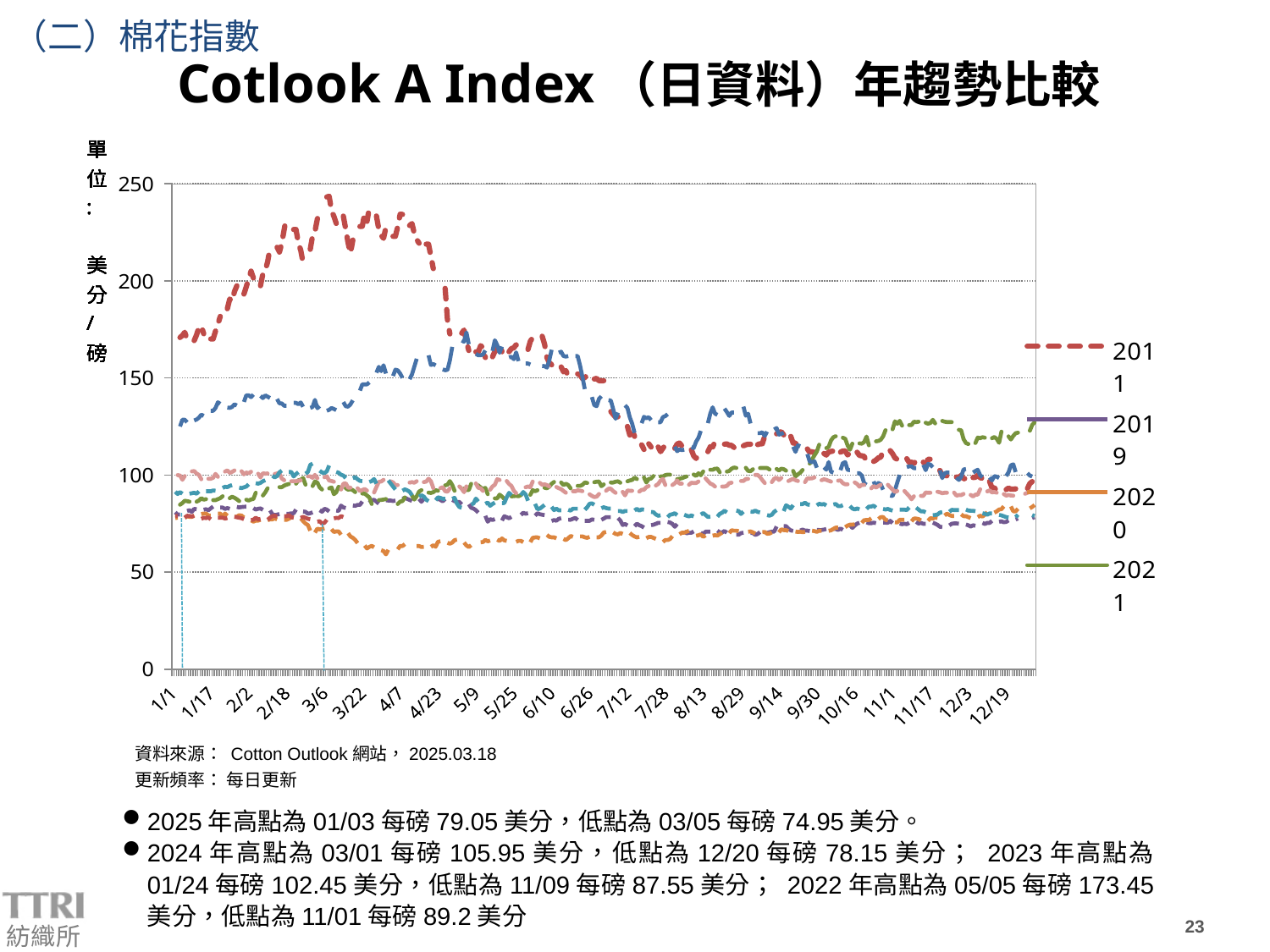
Is the value for the 2020 series on 4/7 greater or less than 100? less What kind of chart is shown on the slide? line chart Which series is higher on 11/1, 2021 or 2020? 2021 Which series is higher on 3/22, 2011 or 2020? 2011 Which series reaches the highest value on the chart? 2011 Is the highest value reached by the 2011 series greater or less than 200? greater What unit is shown on the y axis of the chart? 美分/磅 Is the value for the 2019 series on 8/13 greater or less than 100? less Does the 2021 series rise or fall overall from 1/1 to 12/19? rise What is the title of the chart? Cotlook A Index （日資料）年趨勢比較 Does the 2011 series rise or fall between 4/7 and 7/28? fall